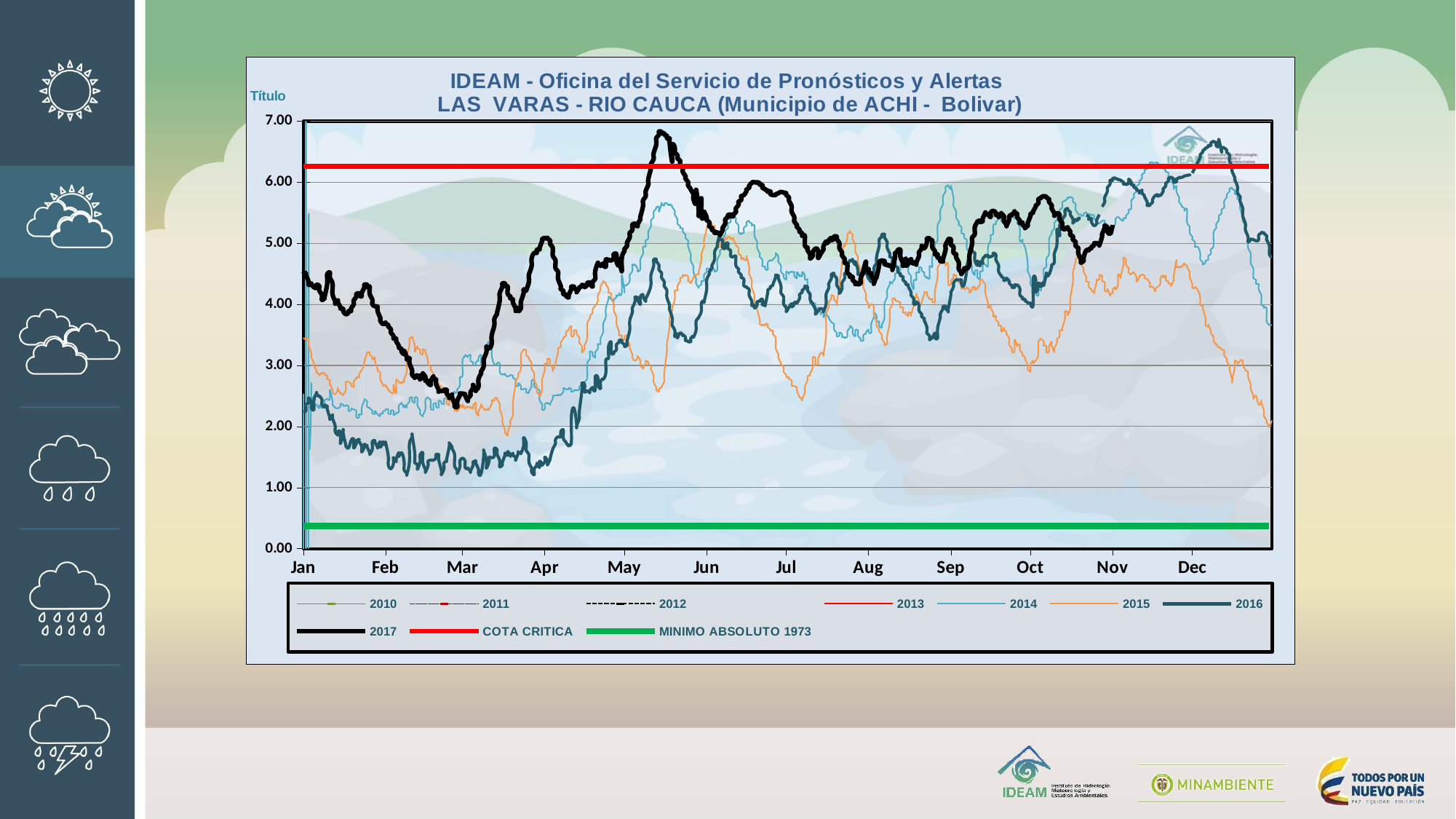
Does the 2017 series rise or fall from March to late May? rise Is the COTA CRITICA line greater or less than 6.00? greater Is the MINIMO ABSOLUTO 1973 line greater or less than 1.00? less Does the 2016 series rise or fall from January to March? fall What kind of chart is shown on the slide? line chart Is the peak value of the 2017 series in late May greater or less than 6.00? greater What colour is the COTA CRITICA line? red How many months are labelled along the x axis? 12 How many series does the legend list? 10 Which year series has the lowest values in March? 2016 Which is larger in February, the 2017 series or the 2016 series? 2017